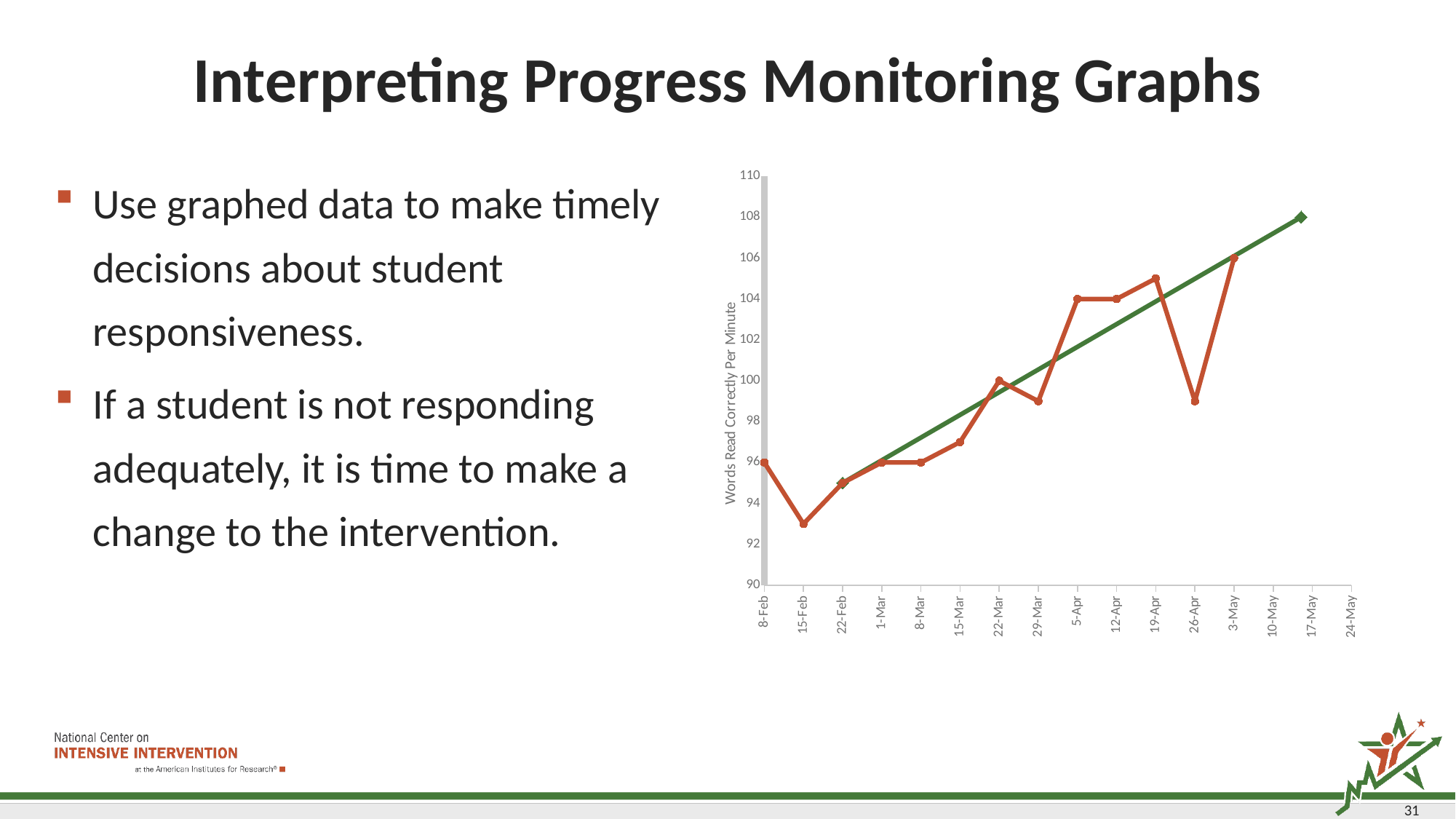
What kind of chart is shown on the slide? line chart On which date is the orange line at its lowest value? 15-Feb Which has the larger value on the orange line, 19-Apr or 26-Apr? 19-Apr Overall, do the values on the orange line rise or fall from 8-Feb to 3-May? rise Is the value for 15-Feb greater or less than 94? less Is the value for 8-Feb greater or less than 98? less What is the label on the vertical axis of the chart? Words Read Correctly Per Minute How many data points are plotted on the orange line? 13 On which date does the orange line reach its highest value? 3-May Which has the larger value on the orange line, 5-Apr or 26-Apr? 5-Apr Is the value for 3-May greater or less than 104? greater